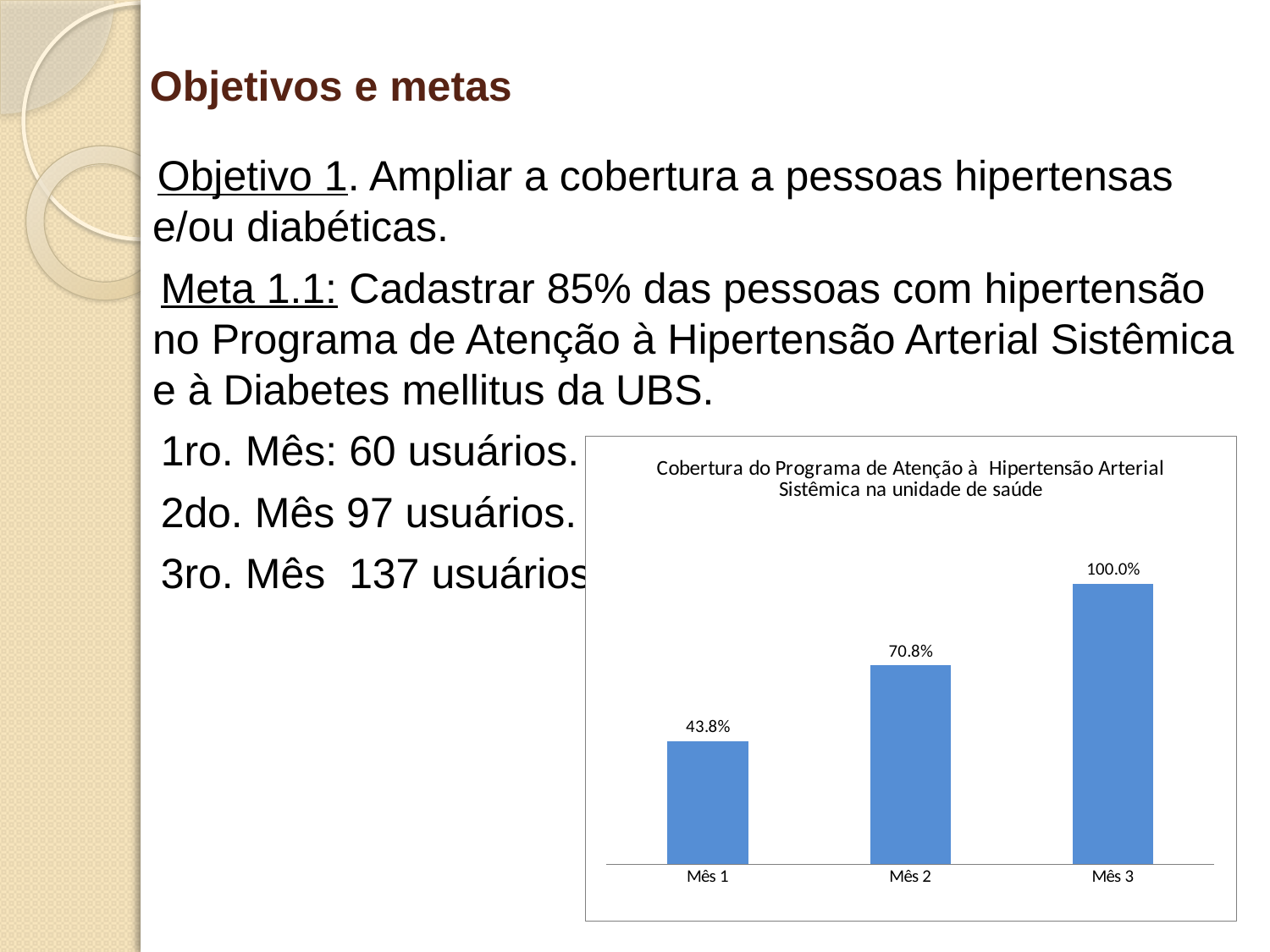
What kind of chart is shown? Bar chart How many months are shown on the x axis? 3 Which is larger, the value for Mês 2 or the value for Mês 1? Mês 2 What is the value for Mês 3? 100.0% What is the difference between the values for Mês 2 and Mês 1? 27.0% What is the title of the chart? Cobertura do Programa de Atenção à Hipertensão Arterial Sistêmica na unidade de saúde What is the difference between the values for Mês 3 and Mês 1? 56.2% Do the values rise or fall from Mês 1 to Mês 3? Rise Which month has the highest value? Mês 3 What is the value for Mês 2? 70.8% Which month has the lowest value? Mês 1 What is the value for Mês 1? 43.8%